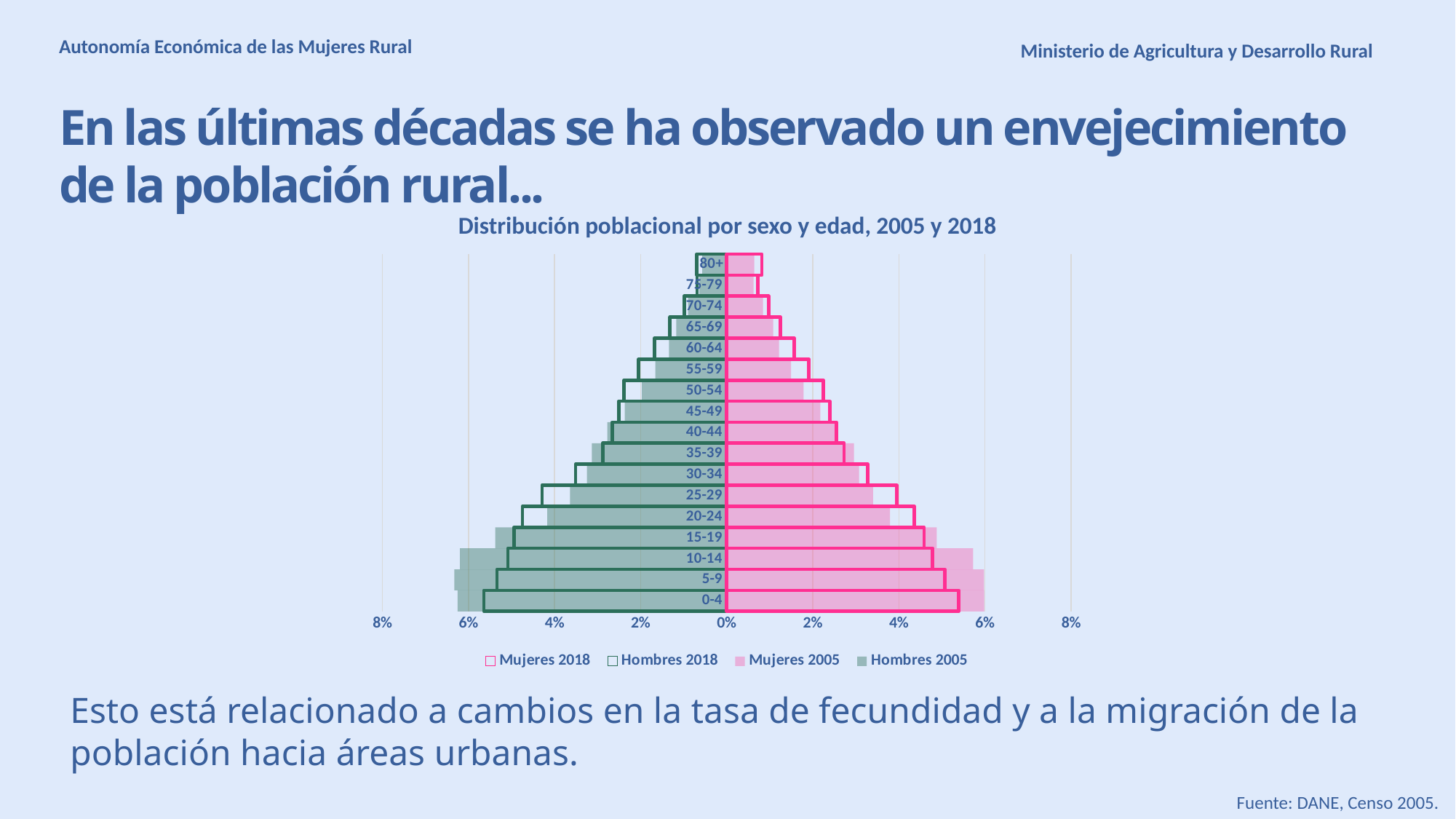
Which age group has the highest value for Hombres 2018? 0-4 Is the value for Mujeres 2018 in the 0-4 age group greater or less than 4%? greater How many series does the chart legend list? 4 For the 45-49 age group, which is larger: Mujeres 2018 or Mujeres 2005? Mujeres 2018 Is the value for Hombres 2018 in the 80+ age group greater or less than 2%? less How many age groups are shown on the chart? 17 For the 10-14 age group, which is larger: Hombres 2005 or Hombres 2018? Hombres 2005 What kind of chart is shown on the slide? Bar chart (population pyramid) What is the title of the chart? Distribución poblacional por sexo y edad, 2005 y 2018 Do the Mujeres 2018 values generally rise or fall as the age groups get older? fall Which age group has the highest value for Mujeres 2018? 0-4 Is the value for Hombres 2005 in the 10-14 age group greater or less than 4%? greater